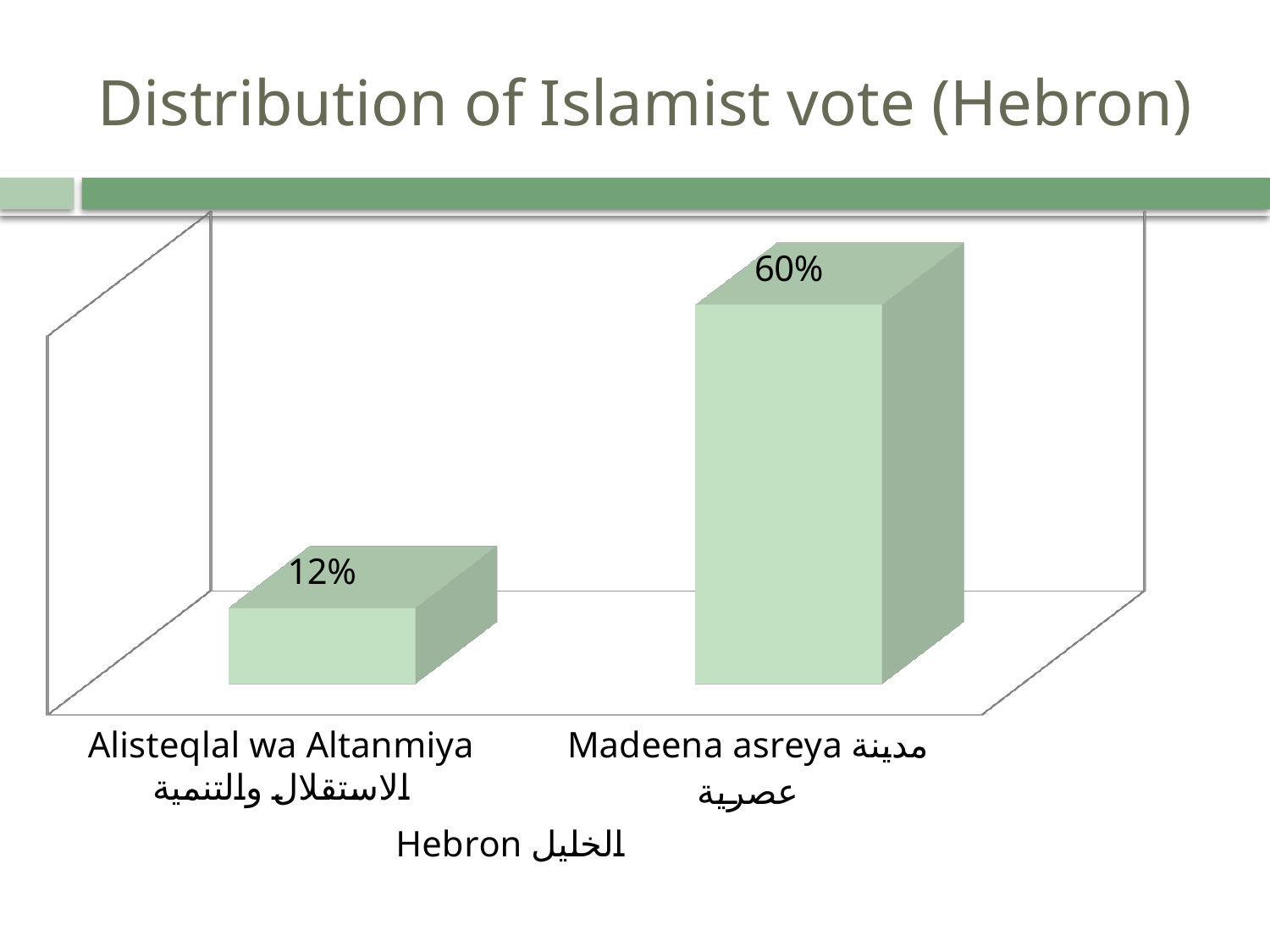
Which is larger, the value for Alisteqlal wa Altanmiya or the value for Madeena asreya? Madeena asreya What is the label shown beneath the category axis? Hebron الخليل What is the value for Alisteqlal wa Altanmiya? 12% Do the values rise or fall from left to right along the x axis? Rise How many categories are shown in the chart? 2 What is the title of the slide? Distribution of Islamist vote (Hebron) What kind of chart is shown on the slide? Bar chart Which category has the highest value? Madeena asreya What is the difference between the values for Madeena asreya and Alisteqlal wa Altanmiya? 48% What is the value for Madeena asreya? 60% Which category has the lowest value? Alisteqlal wa Altanmiya